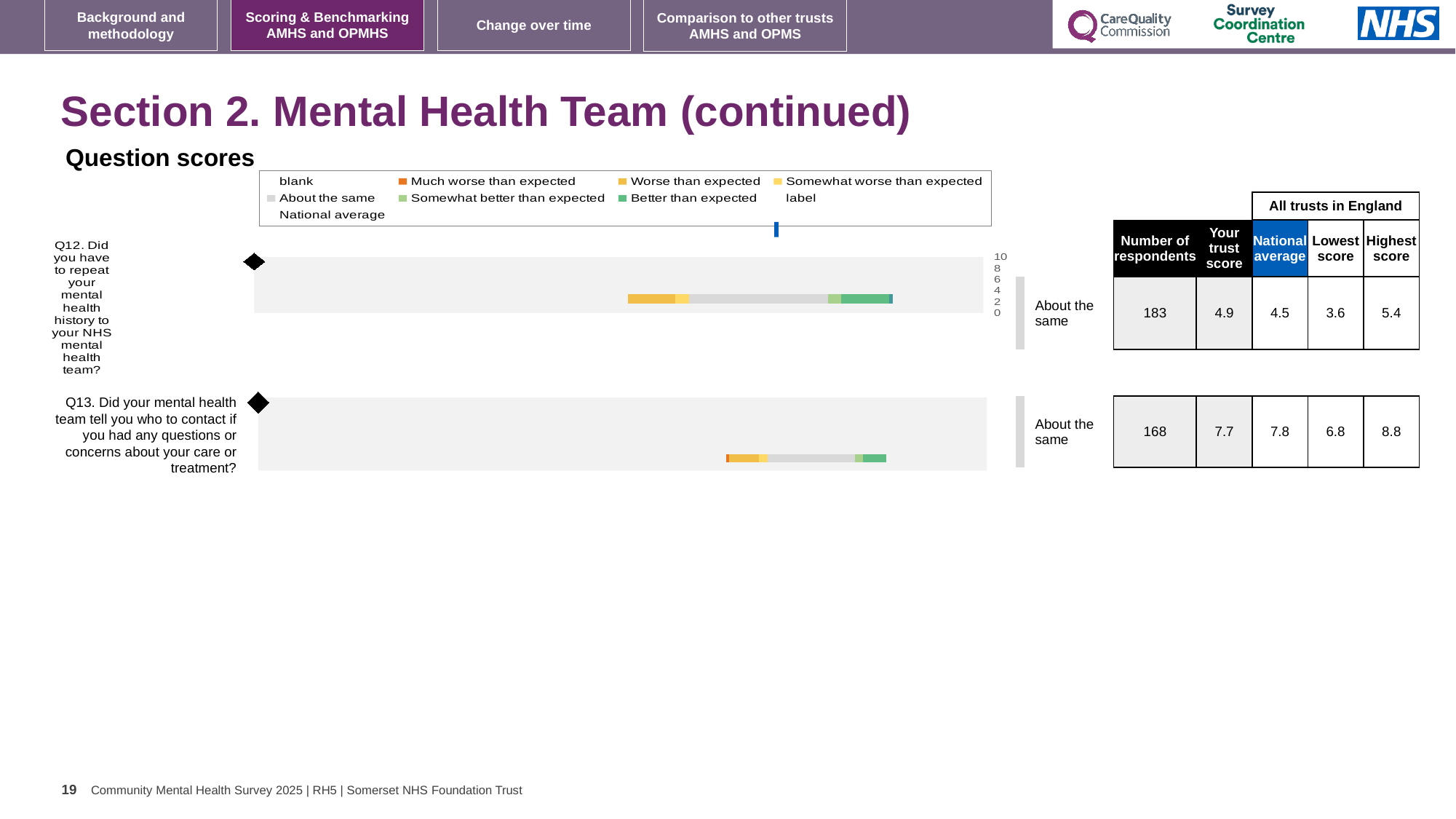
For Q12 (repeating mental health history), which is larger: the trust's score or the national average? the trust's score For Q13 (who to contact with questions or concerns), what is the difference between the highest score and the lowest score? 2.0 In the legend, what colour represents 'Much worse than expected'? orange For Q13 (who to contact with questions or concerns), what is the trust's score? 7.7 What benchmark category is shown next to the Q12 chart? About the same How many questions are plotted on the slide? 2 For Q12 (repeating mental health history), what is the national average? 4.5 What kind of chart is used to show the question scores for Q12 and Q13? bar chart For Q12 (repeating mental health history), what is the trust's score? 4.9 For Q13 (who to contact with questions or concerns), what is the highest score among all trusts in England? 8.8 For Q13 (who to contact with questions or concerns), how many respondents are shown? 168 For Q12 (repeating mental health history), how many respondents are shown? 183